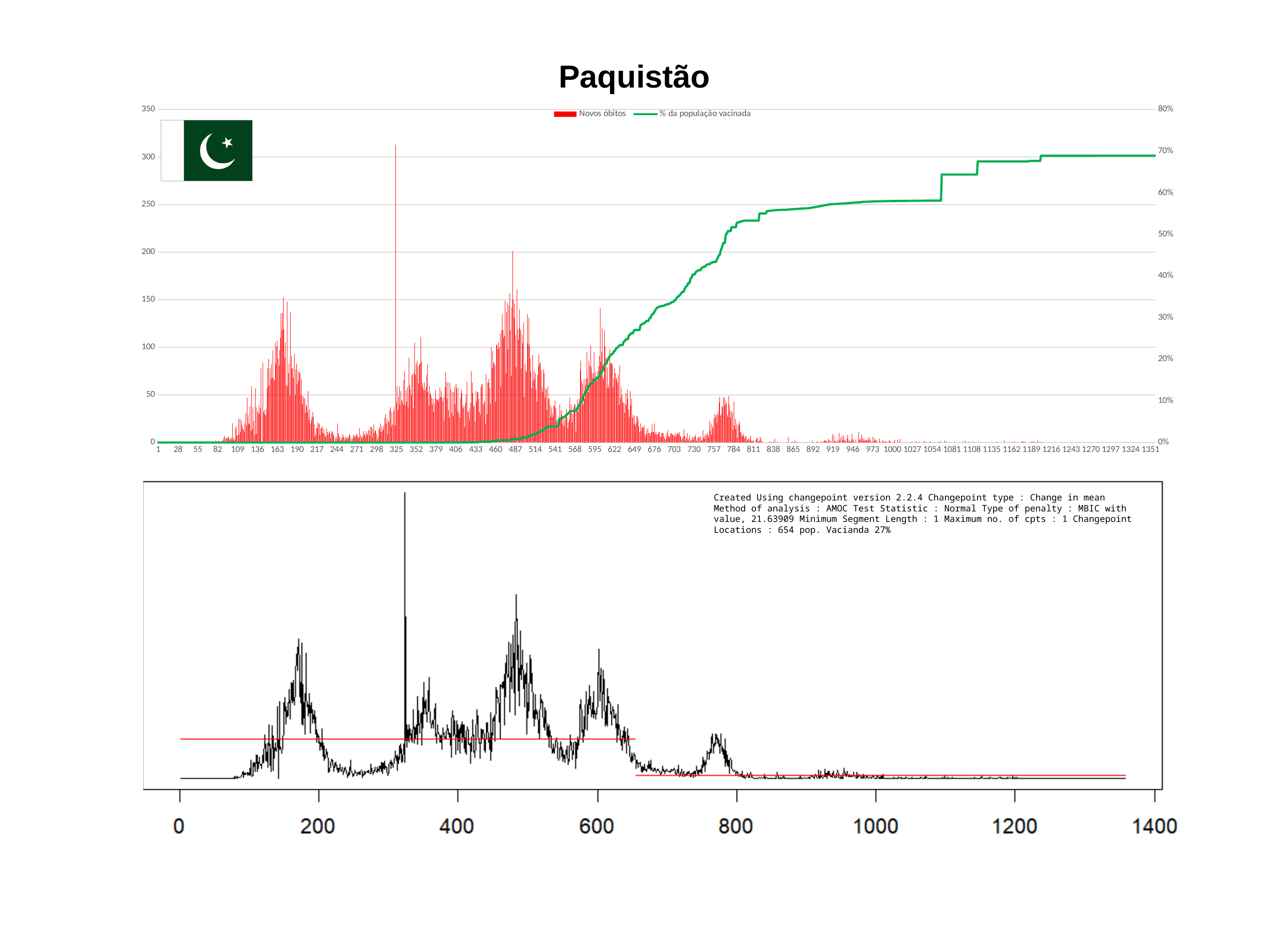
In the top chart, what is the highest value shown on the right-hand percentage axis? 80% In the top chart, how many series does the legend list? 2 In the top chart, is the '% da população vacinada' value at day 325 greater or less than 10%? less In the top chart, is the tallest 'Novos óbitos' bar greater or less than 250? greater In the bottom chart, what vaccinated population percentage is stated in the annotation text? 27% In the top chart, does the '% da população vacinada' line rise or fall along the x axis? rises In the bottom chart, what kind of chart is the black series? line chart In the bottom chart, what changepoint location is stated in the annotation text? 654 What is the title of the top chart? Paquistão In the top chart, is the '% da população vacinada' value at day 1351 greater or less than 60%? greater In the top chart, what kind of chart is used for the 'Novos óbitos' series? bar chart In the top chart, what colour is the '% da população vacinada' line? green